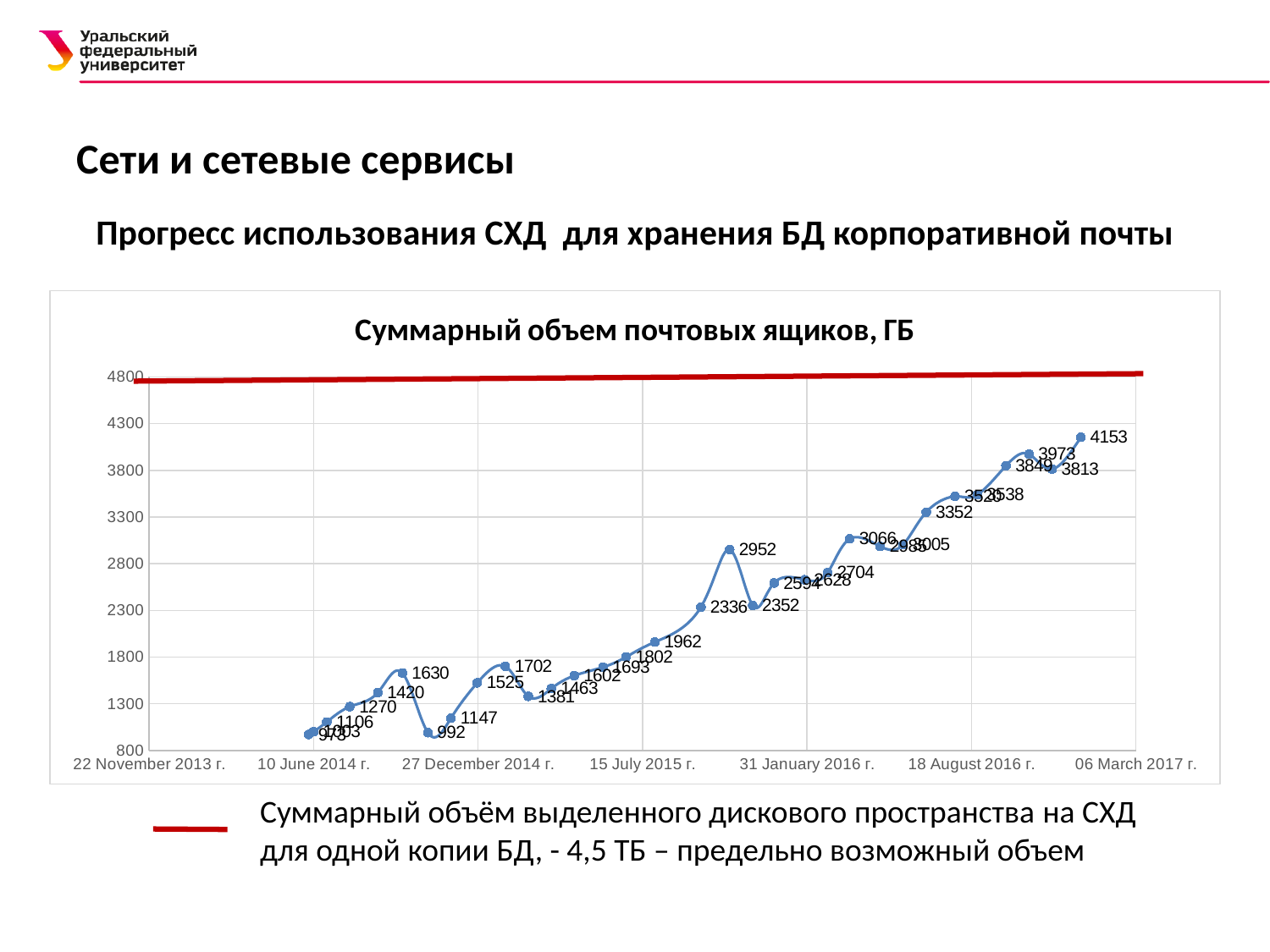
What is the value of the sharp peak that appears shortly before 31 January 2016? 2952 What kind of chart is shown on the slide? line chart What is the highest value labeled on the line? 4153 Is the last point on the line greater or less than 4300? less What is the difference between the points labeled 1630 and 992? 638 What is the title of the chart? Суммарный объем почтовых ящиков, ГБ What is the value of the point immediately after the 2952 peak? 2352 What is the difference between the 2952 peak and the following 2352 point? 600 What is the difference between the points labeled 3352 and 3066? 286 Which is larger, the point labeled 3973 or the point labeled 3813? 3973 Overall, do the values rise or fall along the x axis from 2013 to 2017? rise What is the highest tick value shown on the y axis? 4800